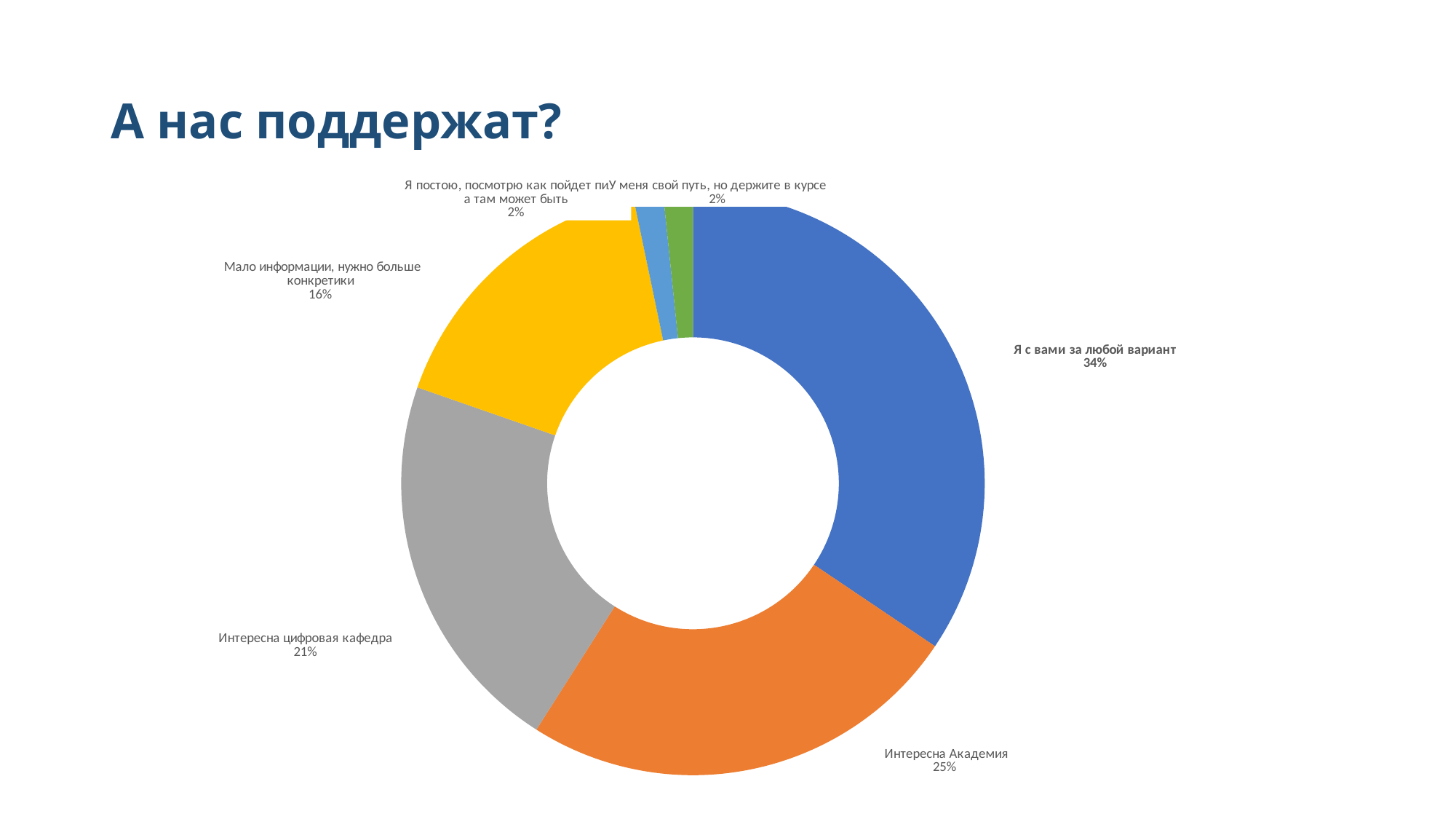
Which category has the largest share of the chart? Я с вами за любой вариант What percentage is shown for "Интересна цифровая кафедра"? 21% What is the difference in percentage points between "Я с вами за любой вариант" and "Интересна Академия"? 9 What percentage is shown for "У меня свой путь, но держите в курсе"? 2% What share is labelled for "Мало информации, нужно больше конкретики"? 16% Which is larger: "Интересна цифровая кафедра" or "Мало информации, нужно больше конкретики"? Интересна цифровая кафедра What kind of chart is shown on the slide? Doughnut (pie) chart How many slices does the chart have? 6 What percentage is shown for "Интересна Академия"? 25% What share of responses is "Я с вами за любой вариант"? 34% What colour is the slice for "Интересна Академия"? Orange What is the title of the slide? А нас поддержат?